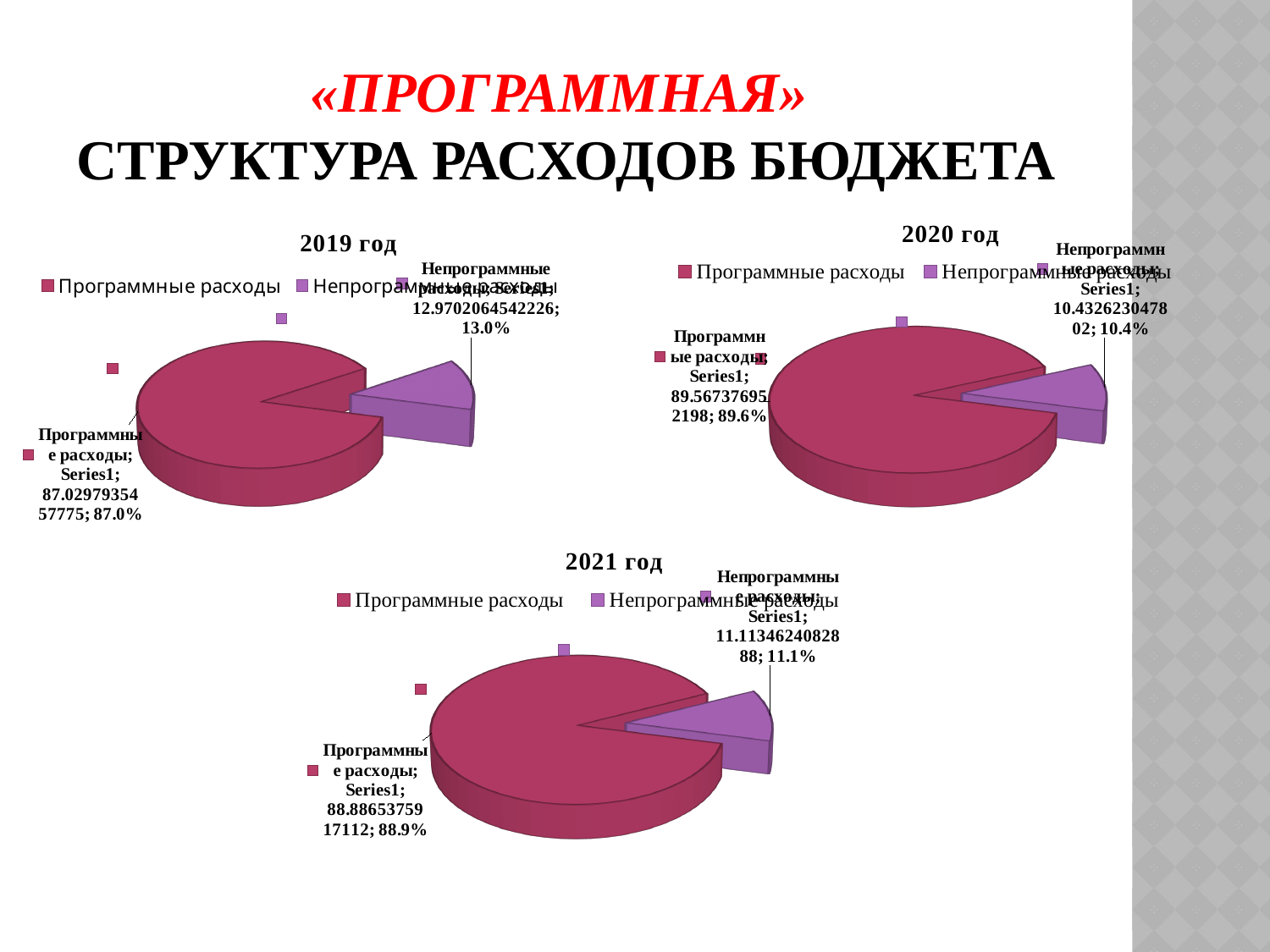
How many pie charts are shown on the slide? 3 In the "2020 год" chart, what percentage share is shown for Непрограммные расходы? 10.4% In the "2021 год" chart, what percentage share is shown for Программные расходы? 88.9% How many slices does the "2020 год" pie chart have? 2 In the "2019 год" chart, which category has the largest slice? Программные расходы In the "2021 год" chart, what percentage share is shown for Непрограммные расходы? 11.1% What kind of chart is the "2021 год" chart? Pie chart In the "2020 год" chart, which is larger: Программные расходы or Непрограммные расходы? Программные расходы In the "2021 год" chart, which category has the smallest slice? Непрограммные расходы